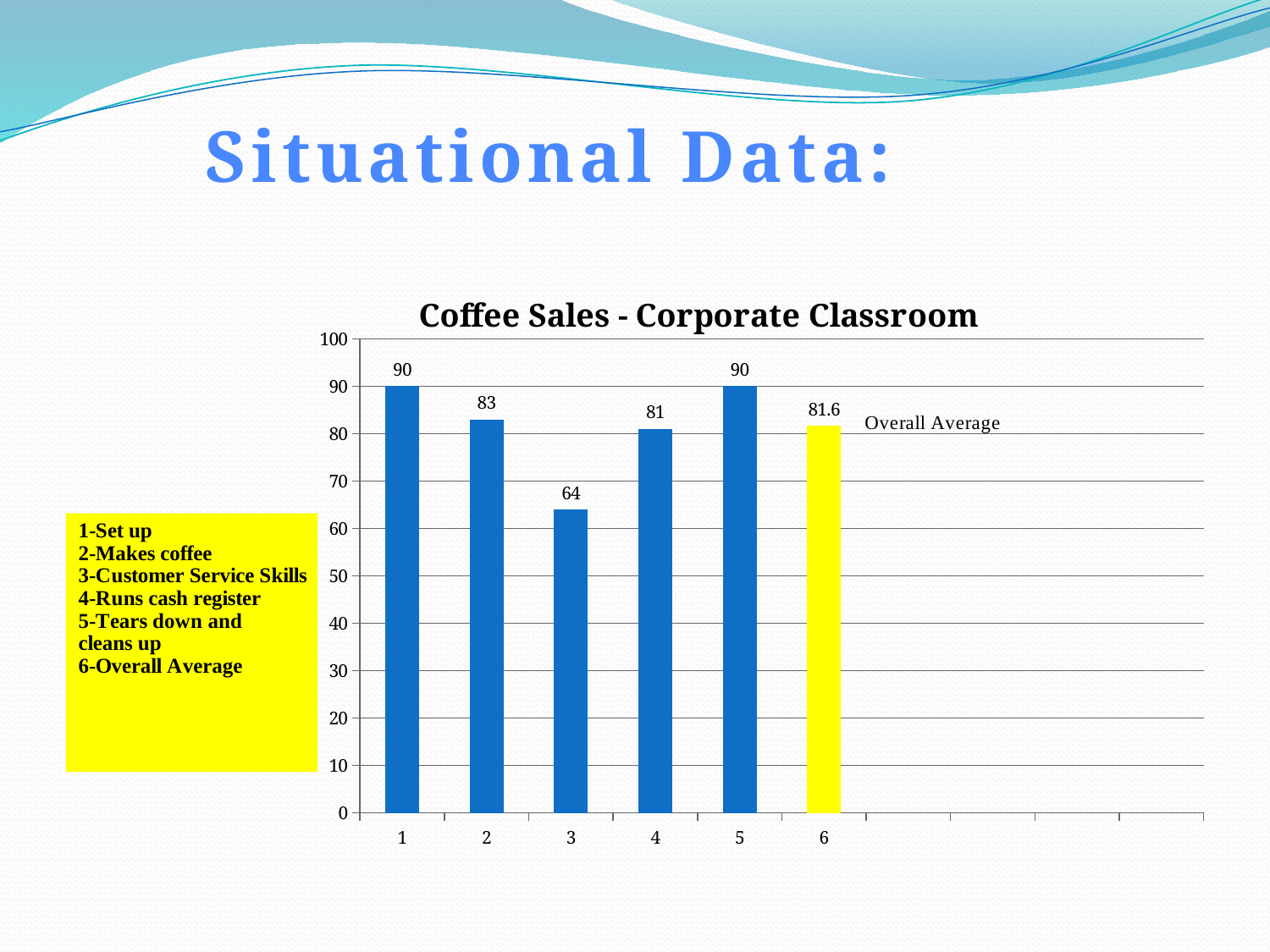
What kind of chart is shown on the slide? Bar chart Which category has the lowest value in the chart? 3 What is the value for category 3 in the Coffee Sales - Corporate Classroom chart? 64 What is the difference between the value for category 5 and the Overall Average (category 6)? 8.4 Which is larger, the value for category 2 or the value for category 4? Category 2 What colour is the bar for category 6 (Overall Average)? Yellow What is the difference between the values for category 2 and category 3? 19 What is the value for category 6 (Overall Average) in the chart? 81.6 Is the value for category 3 greater or less than 70? less What is the value for category 1 in the Coffee Sales - Corporate Classroom chart? 90 What is the title of the chart? Coffee Sales - Corporate Classroom How many bars are plotted in the chart? 6